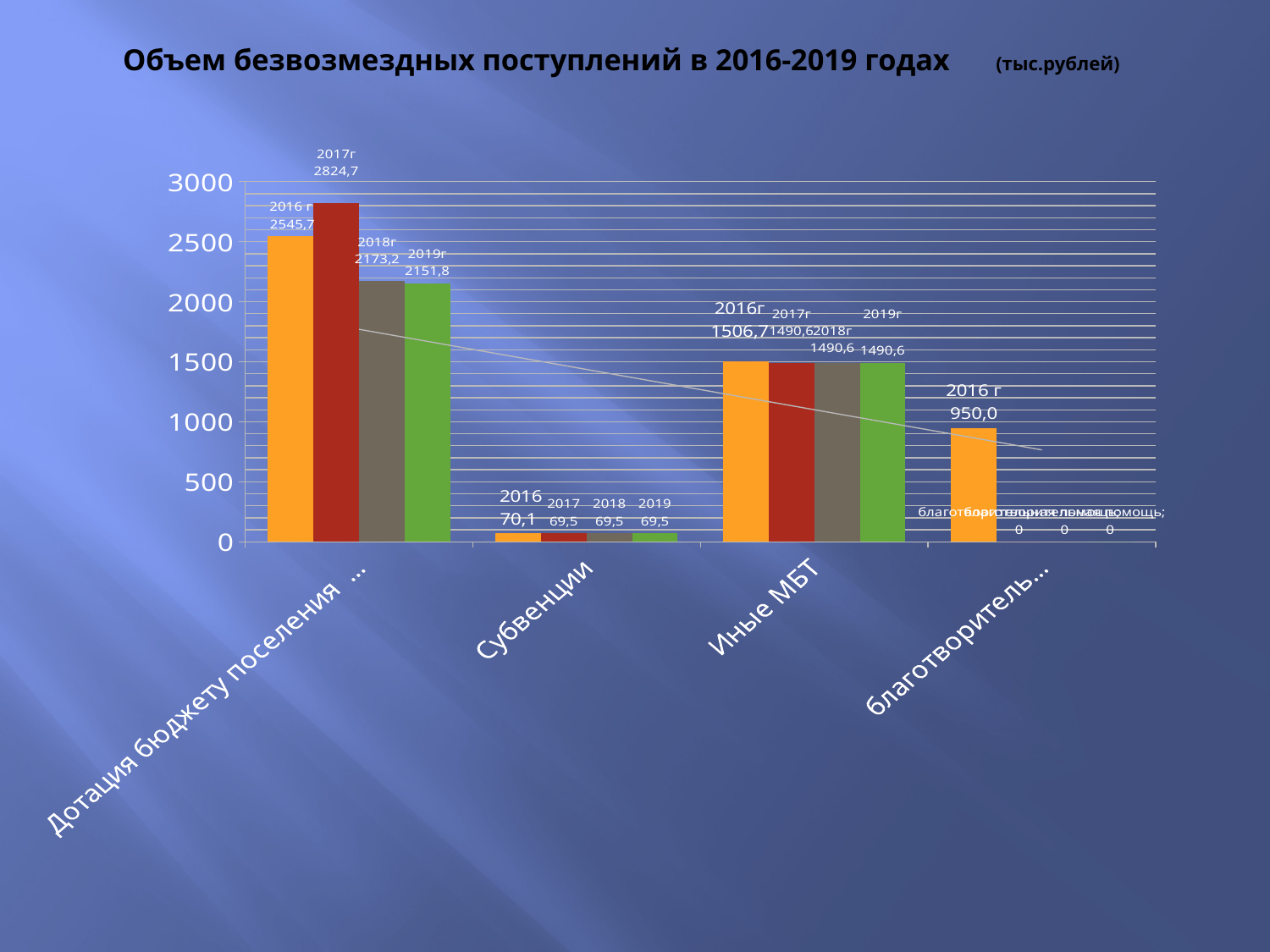
How many categories are shown along the x axis? 4 What is the 2019 value for Иные МБТ? 1490,6 Which is larger: the 2016 value for Иные МБТ or the 2016 value for the last category (благотворитель...)? Иные МБТ What is the difference between the 2017 and 2016 values for the first category (Дотация бюджету поселения)? 279,0 What is the value for Иные МБТ in 2016? 1506,7 Is the 2018 value for the first category (Дотация бюджету поселения) greater or less than 2000? greater What is the 2017 value for the first category (Дотация бюджету поселения)? 2824,7 What is the title of the chart? Объем безвозмездных поступлений в 2016-2019 годах Which year has the highest value for the first category (Дотация бюджету поселения)? 2017 What kind of chart is shown on the slide? bar chart What is the value for Субвенции in 2016? 70,1